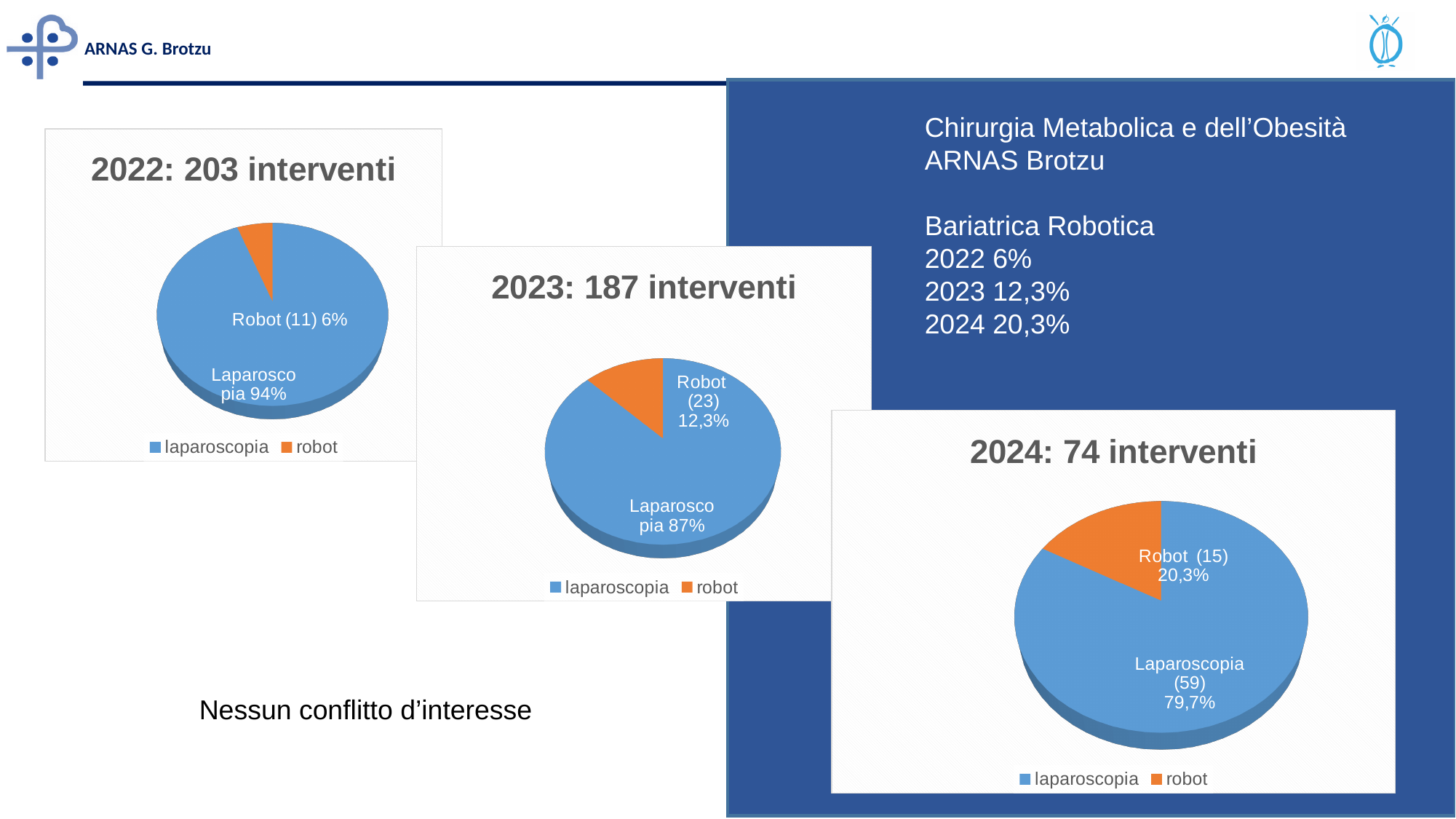
In the chart titled "2022: 203 interventi", how many interventions does the Robot slice represent? 11 In the chart titled "2024: 74 interventi", what share of the pie is the laparoscopia slice? 79,7% In the chart titled "2024: 74 interventi", which slice is larger, laparoscopia or robot? laparoscopia In the chart titled "2022: 203 interventi", what share of the pie is the robot slice? 6% In the chart titled "2024: 74 interventi", what is the difference in interventions between the Laparoscopia slice (59) and the Robot slice (15)? 44 In the chart titled "2024: 74 interventi", how many interventions does the Laparoscopia slice represent? 59 In the chart titled "2023: 187 interventi", what share of the pie is the robot slice? 12,3% In the chart titled "2023: 187 interventi", what colour is the robot slice? orange In the chart titled "2023: 187 interventi", how many interventions does the Robot slice represent? 23 What kind of chart is the one titled "2023: 187 interventi"? pie chart How many entries does the legend of the chart titled "2022: 203 interventi" list? 2